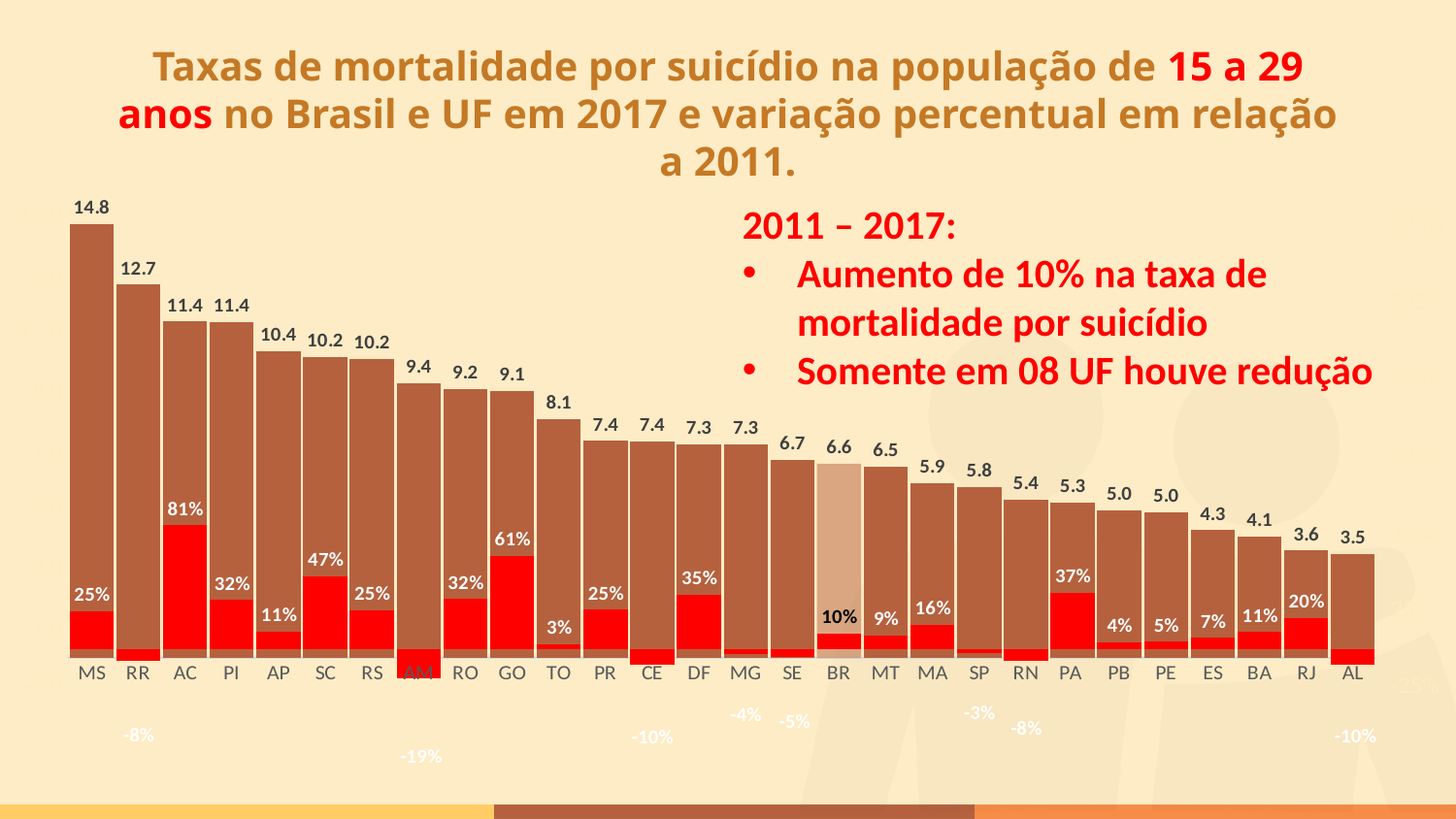
What kind of chart is shown on the slide? Bar chart What is the mortality rate shown for PA? 5.3 Which has a higher mortality rate, TO or SE? TO What is the suicide mortality rate shown for BR (Brazil)? 6.6 Which state has the lowest suicide mortality rate in the chart? AL What is the suicide mortality rate shown for MS? 14.8 Do the mortality rate values rise or fall from left to right along the x axis? Fall How many categories (bars) are shown along the x axis? 28 What percentage variation is shown for GO? 61% Which state has the highest suicide mortality rate in the chart? MS What percentage variation is shown for AC? 81% What is the difference between the mortality rates of MS and RR? 2.1